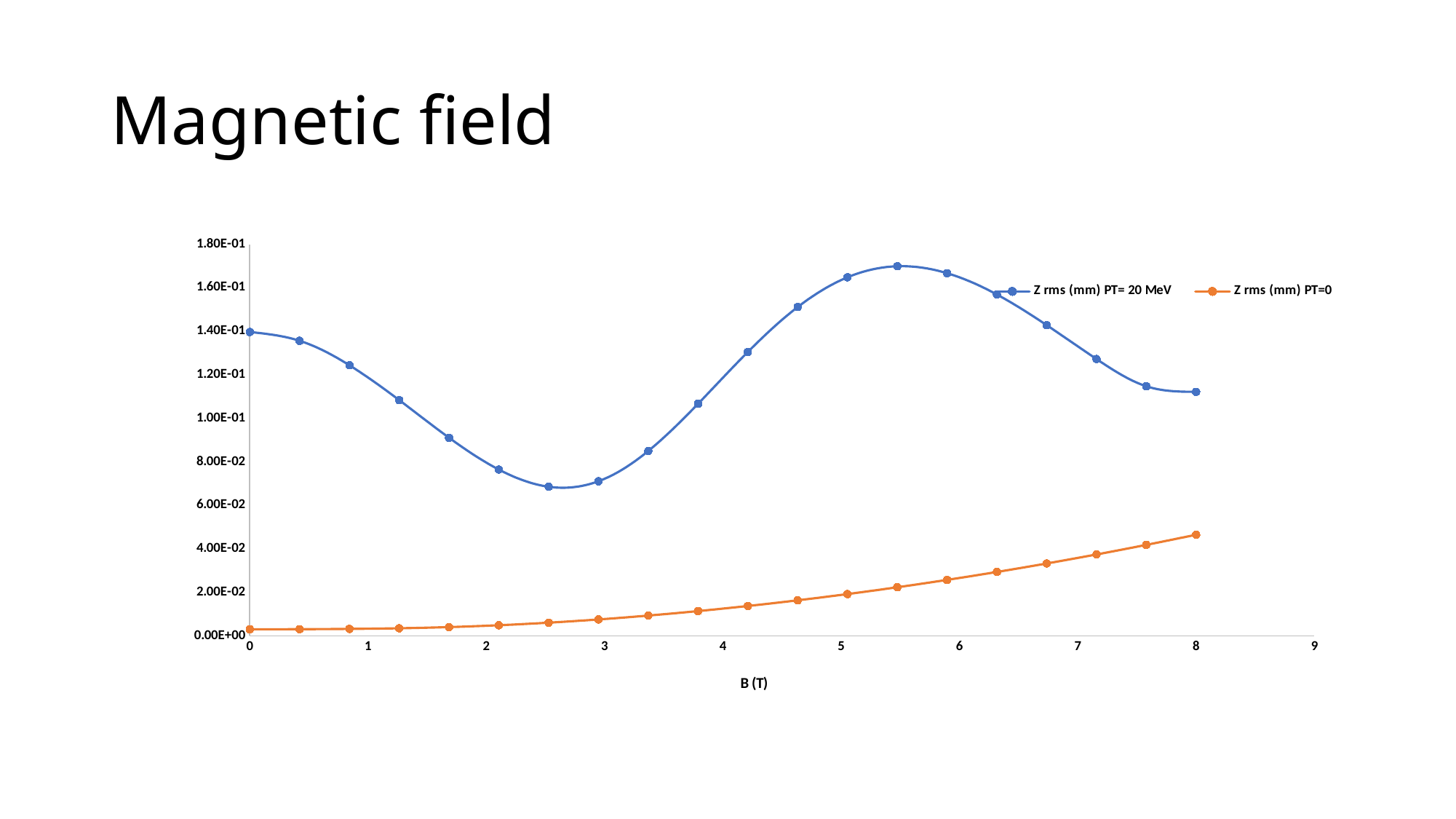
How many series does the legend list? 2 How many data points are plotted for the Z rms (mm) PT=0 series? 20 Is the highest value reached by the Z rms (mm) PT= 20 MeV series greater or less than 1.60E-01? greater What are the two series names shown in the legend? Z rms (mm) PT= 20 MeV and Z rms (mm) PT=0 What is the x-axis title of the chart? B (T) Is the value of the Z rms (mm) PT=0 series at B = 8 greater or less than 4.00E-02? greater What kind of chart is shown on the slide? line chart Is the value of the Z rms (mm) PT= 20 MeV series at B = 0 greater or less than 1.20E-01? greater Does the Z rms (mm) PT=0 series rise or fall as B increases from 0 to 8? rise At B = 0, which series has the higher value, Z rms (mm) PT= 20 MeV or Z rms (mm) PT=0? Z rms (mm) PT= 20 MeV